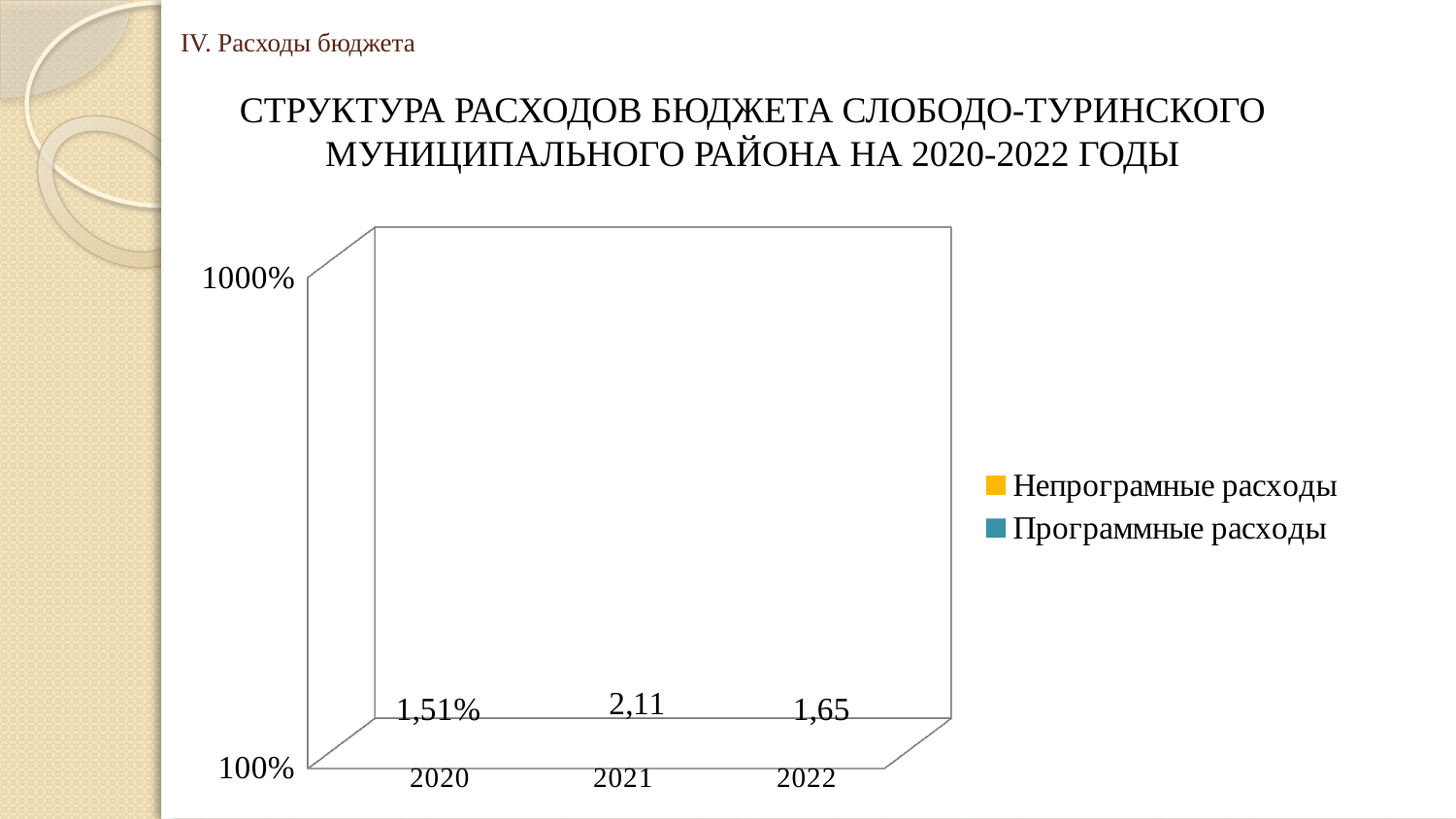
What data label is printed above the 2021 category on the chart? 2,11 How many categories are shown on the x axis of the chart? 3 What data label is printed above the 2022 category on the chart? 1,65 What data label is printed above the 2020 category on the chart? 1,51% Which year has the lowest printed data label on the chart? 2020 Which is larger on the chart: the printed label for 2021 or the printed label for 2022? 2021 What are the category labels on the x axis of the chart? 2020, 2021, 2022 How many series does the chart legend list? 2 What are the two legend entries of the chart? Непрограмные расходы, Программные расходы Which year has the highest printed data label on the chart? 2021 What is the title of the chart on the slide? СТРУКТУРА РАСХОДОВ БЮДЖЕТА СЛОБОДО-ТУРИНСКОГО МУНИЦИПАЛЬНОГО РАЙОНА НА 2020-2022 ГОДЫ